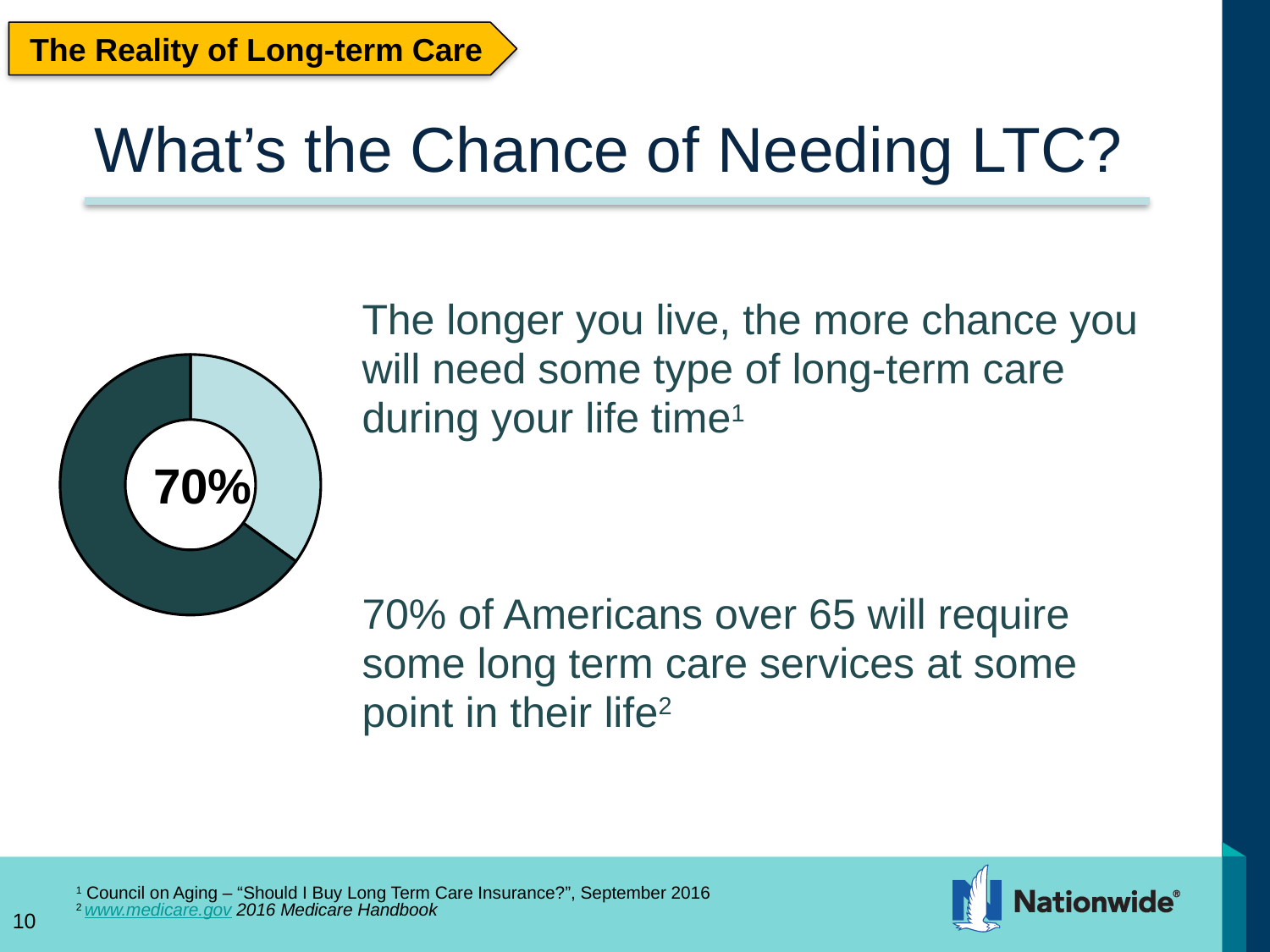
How many slices does the donut chart have? 2 Is the share of the dark teal slice in the donut chart greater or less than 50%? greater Is the share of the light blue slice in the donut chart greater or less than 50%? less What percentage is printed in the centre of the donut chart? 70% Which slice of the donut chart is larger, the dark teal slice or the light blue slice? The dark teal slice What colour is the larger slice of the donut chart? Dark teal What kind of chart is shown on the left of the slide? Donut (pie) chart What share of the donut chart does the dark teal slice represent, according to the label on the chart? 70% Does the donut chart have a legend? No